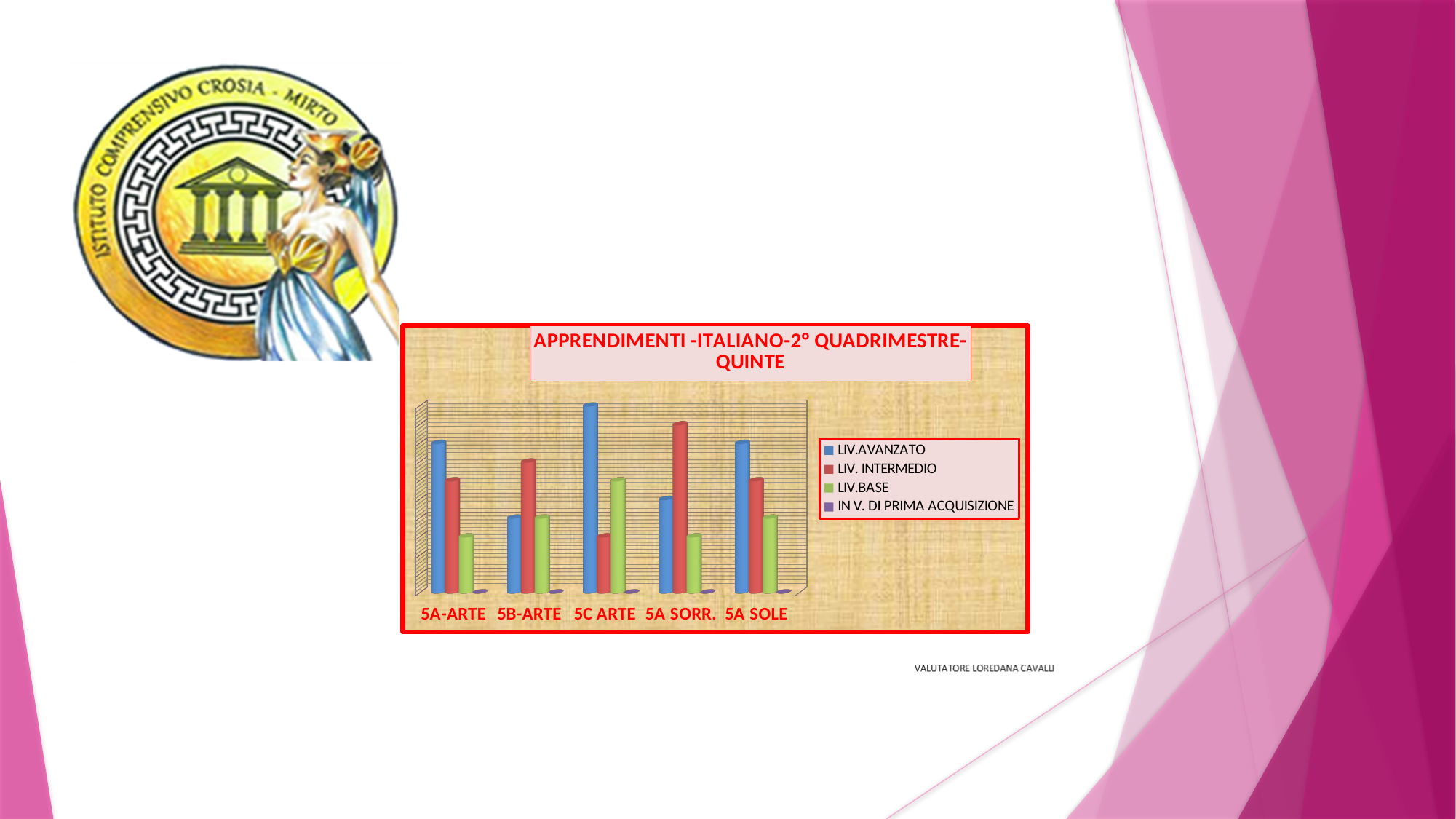
What is the title of the chart? APPRENDIMENTI -ITALIANO-2° QUADRIMESTRE-QUINTE In 5A SORR., which is larger: LIV.AVANZATO or LIV. INTERMEDIO? LIV. INTERMEDIO Which class has the lowest LIV. INTERMEDIO bar? 5C ARTE How many classes (categories) are shown on the x axis of the chart? 5 Which class has the highest LIV.BASE bar? 5C ARTE Which class has the highest LIV.AVANZATO bar? 5C ARTE In 5B-ARTE, which is larger: LIV. INTERMEDIO or LIV.AVANZATO? LIV. INTERMEDIO In 5A-ARTE, which is larger: LIV.AVANZATO or LIV. INTERMEDIO? LIV.AVANZATO What kind of chart is shown on the slide? Bar chart Which class has the highest LIV. INTERMEDIO bar? 5A SORR. How many series does the chart legend list? 4 Which colour represents LIV.BASE in the chart? Green